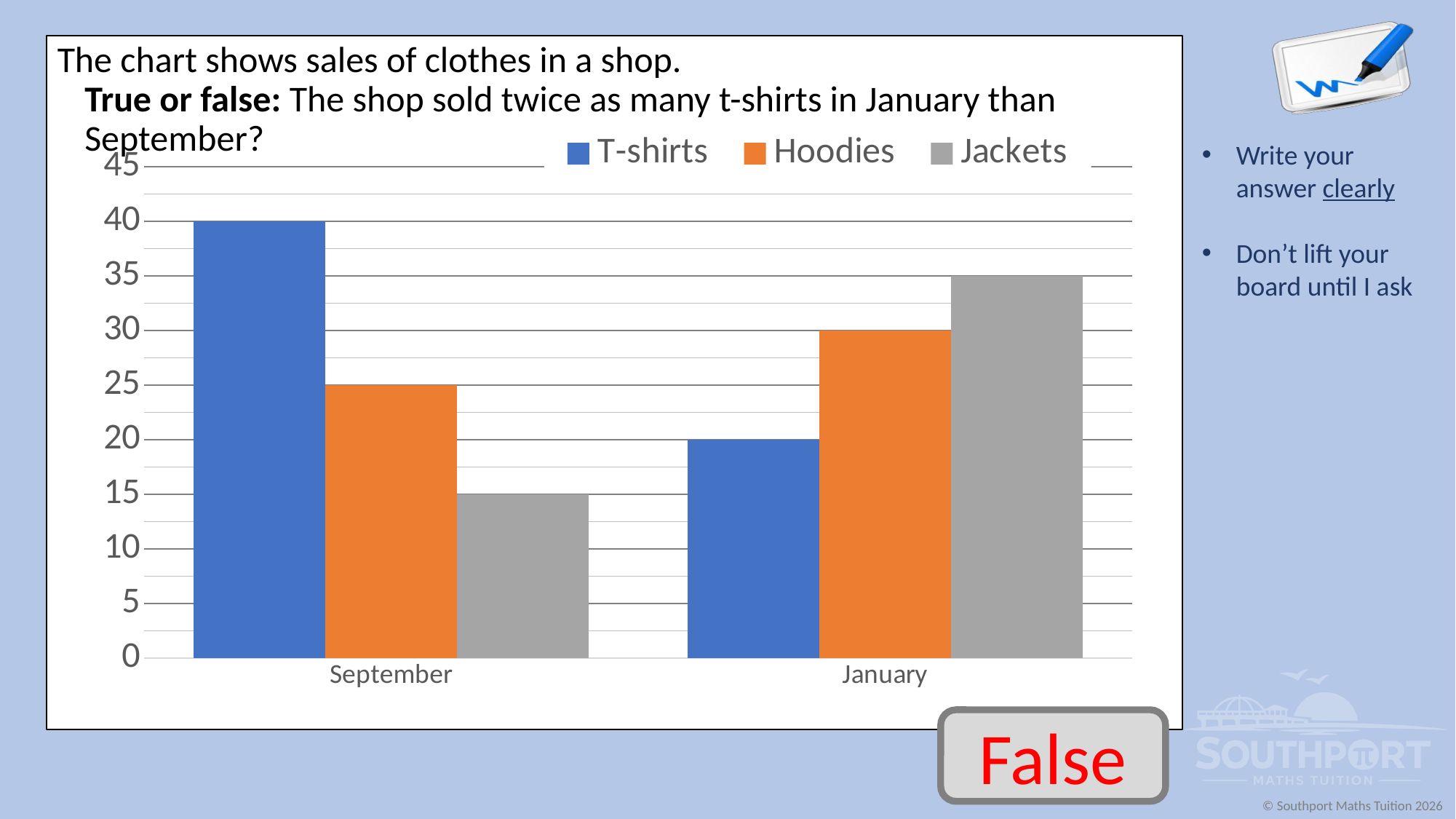
What is the value for Hoodies in January? 30 How many categories are shown on the x axis? 2 What kind of chart is shown on the slide? bar chart What is the difference between T-shirts sales in September and January? 20 What is the value for T-shirts in January? 20 How many series does the legend list? 3 Which series has the highest value in January? Jackets What is the value for T-shirts in September? 40 Which series has the lowest value in September? Jackets Which is larger: Hoodies in September or Hoodies in January? Hoodies in January What is the value for Jackets in September? 15 Which series is shown in orange in the legend? Hoodies